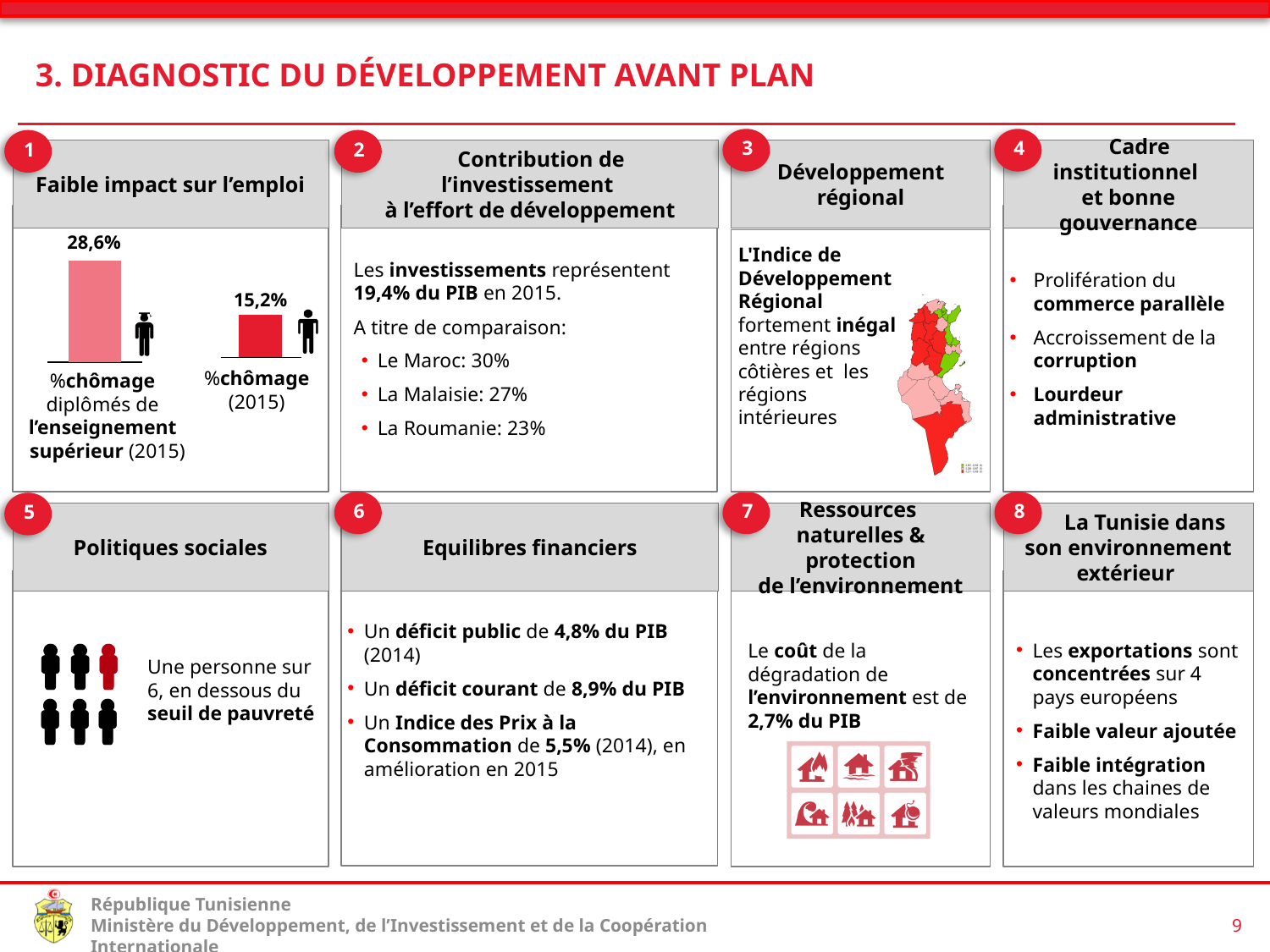
In the bar chart under "Faible impact sur l'emploi", what is the value shown for % chômage diplômés de l'enseignement supérieur (2015)? 28,6% In the bar chart under "Faible impact sur l'emploi", is the value for % chômage (2015) greater or less than 20%? less In the bar chart under "Faible impact sur l'emploi", what is the value shown for % chômage (2015)? 15,2% In the bar chart under "Faible impact sur l'emploi", what is the difference between the unemployment rate of higher-education graduates and the overall unemployment rate in 2015? 13,4 percentage points What is the title of the panel containing the bar chart on this slide? Faible impact sur l'emploi What kind of chart is shown in the panel "Faible impact sur l'emploi"? Bar chart In the bar chart under "Faible impact sur l'emploi", which category has the highest value? % chômage diplômés de l'enseignement supérieur (2015) In the bar chart under "Faible impact sur l'emploi", which is larger: the unemployment rate of higher-education graduates or the overall unemployment rate (2015)? The unemployment rate of higher-education graduates In the bar chart under "Faible impact sur l'emploi", which category has the lowest value? % chômage (2015) How many bars are shown in the chart under "Faible impact sur l'emploi"? 2